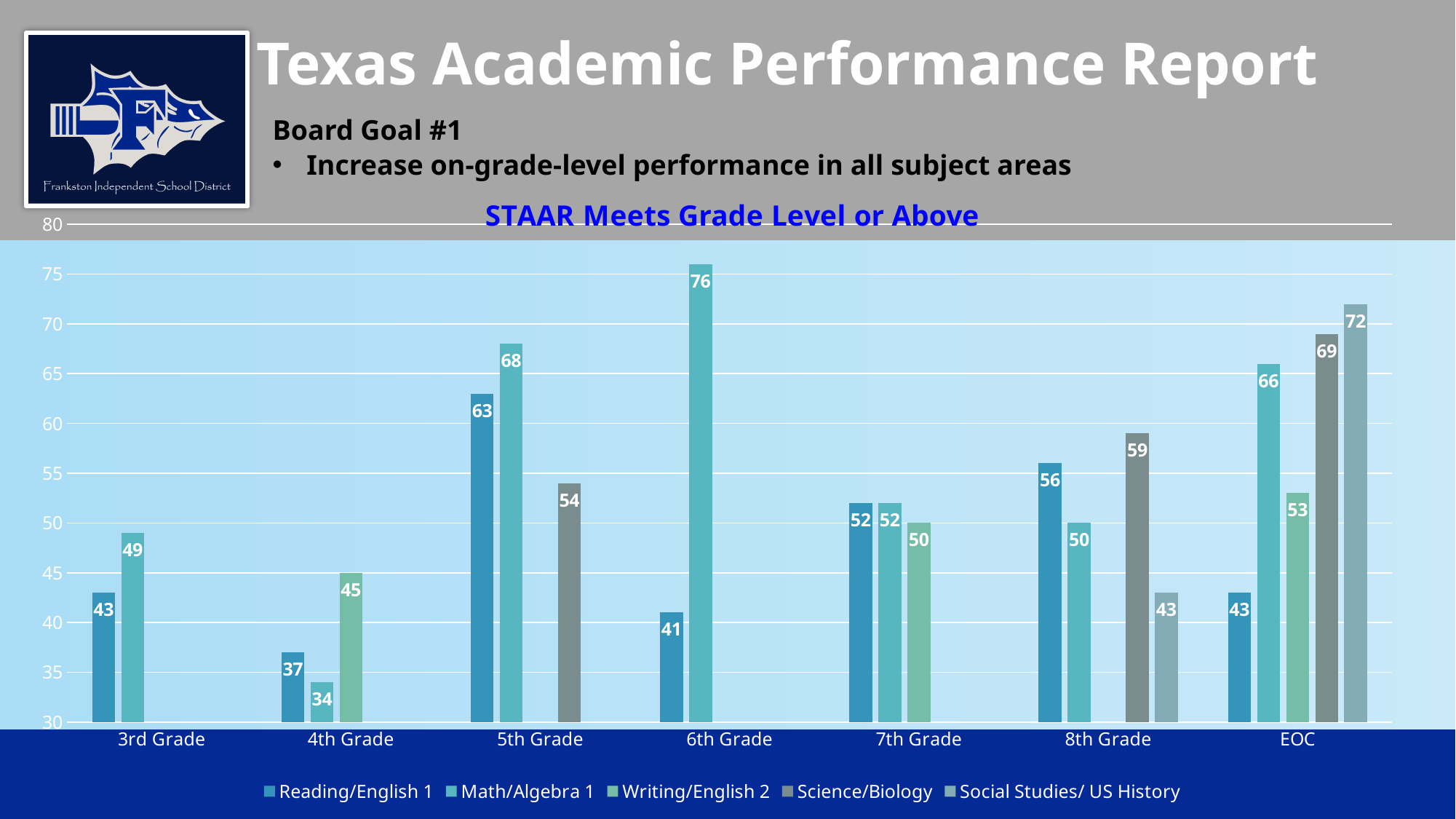
What is the Science/Biology value for 8th Grade? 59 Which grade has the highest Math/Algebra 1 value? 6th Grade What is the difference between the Math/Algebra 1 and Reading/English 1 values for 6th Grade? 35 How many grade-level categories are shown on the x axis? 7 What type of chart is shown on the slide? Bar chart How many series does the legend list? 5 What is the Reading/English 1 value for 5th Grade? 63 Is the Science/Biology value for 5th Grade greater or less than 50? greater Which grade has the lowest Reading/English 1 value? 4th Grade Which is larger for 4th Grade, Reading/English 1 or Writing/English 2? Writing/English 2 What is the Social Studies/ US History value for EOC? 72 What is the Math/Algebra 1 value for 6th Grade? 76